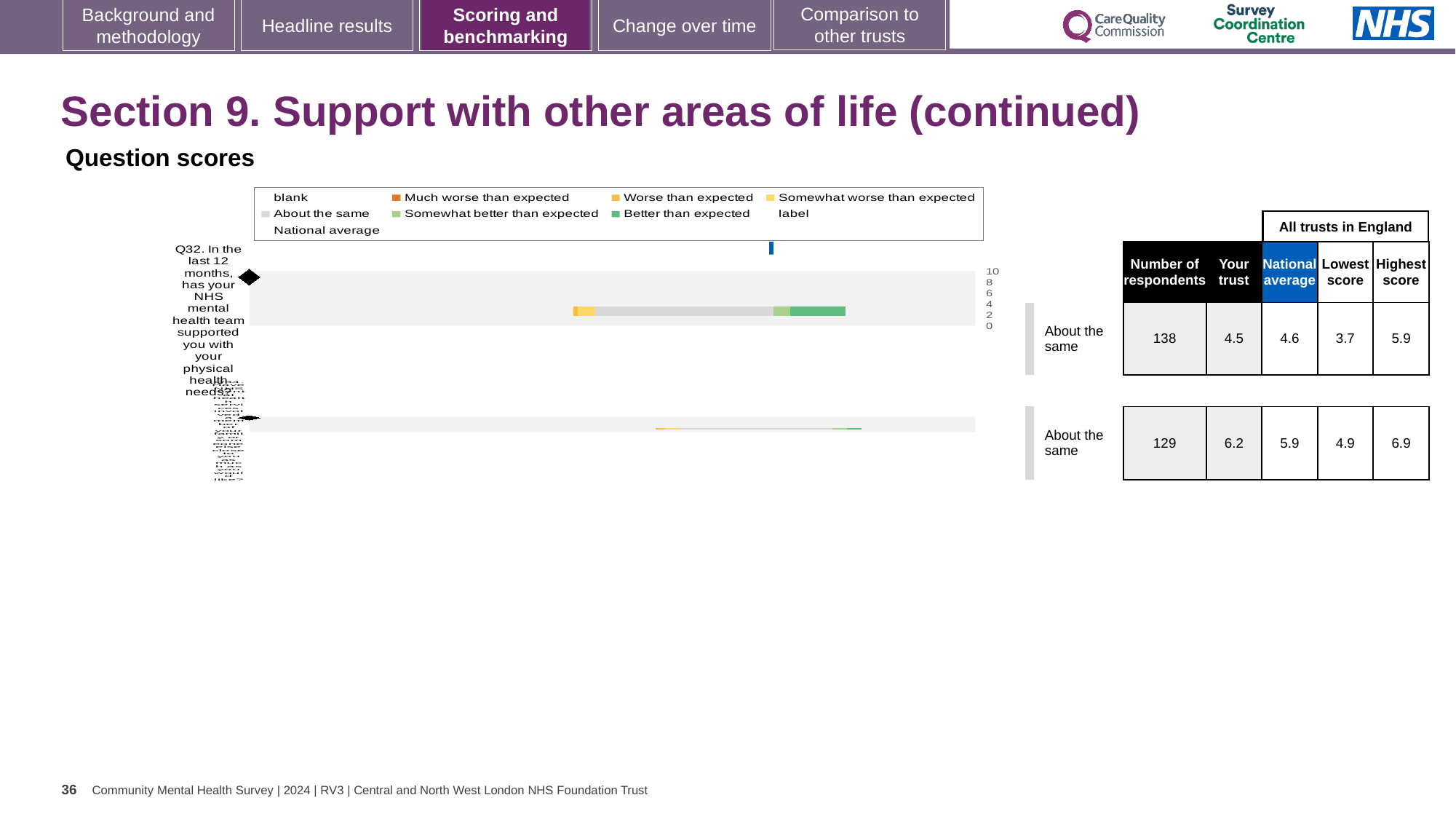
What is the 'Your trust' score for Q32 (support with physical health needs)? 4.5 What is the difference between the highest and lowest scores for Q32 across all trusts in England? 2.2 What colour represents 'Better than expected' in the legend? green How many entries does the legend of the question scores chart list? 9 For Q32, which is larger: the trust's score or the national average? national average What kind of chart is shown under 'Question scores'? bar chart How many question bars are plotted in the question scores chart? 2 Which benchmark category is the trust's Q32 score placed in? About the same What is the highest score among all trusts in England for Q32? 5.9 How many respondents answered Q32? 138 What is the lowest score among all trusts in England for Q32? 3.7 What is the national average score for Q32? 4.6